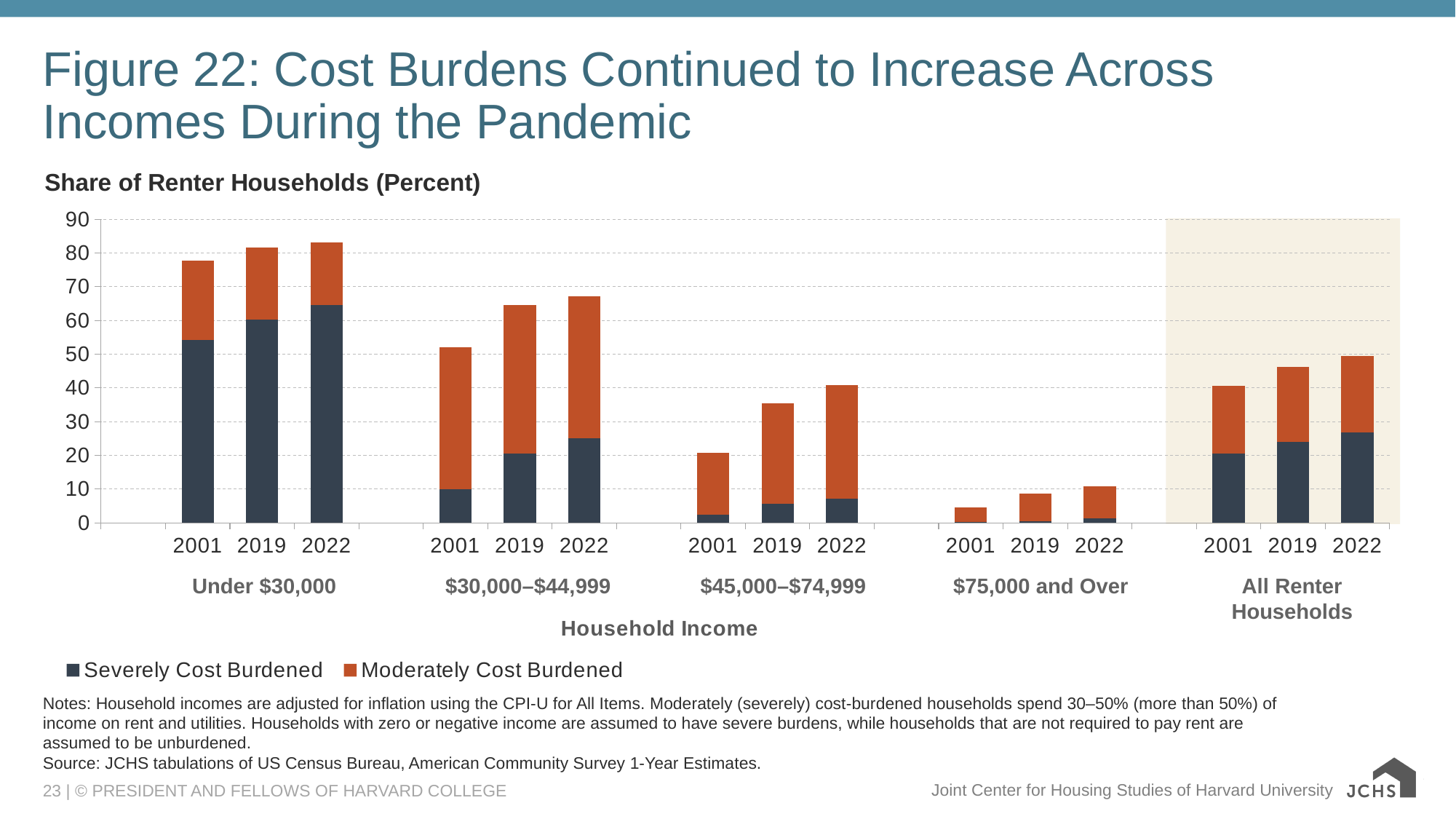
How many series does the legend list? 2 What are the two series named in the legend? Severely Cost Burdened and Moderately Cost Burdened What kind of chart is shown on the slide? Stacked bar chart Which income group and year has the highest total share of cost-burdened renter households? Under $30,000 in 2022 Is the Severely Cost Burdened share for the Under $30,000 group in 2022 greater or less than 60? greater Is the total cost-burdened share for the $45,000–$74,999 group in 2019 greater or less than 30? greater Is the total cost-burdened share for All Renter Households in 2022 greater or less than 40? greater Within each income group, do the total cost-burdened shares rise or fall from 2001 to 2022? rise How many bars are plotted in the chart? 15 In 2022, which group has a larger total cost-burdened share: $30,000–$44,999 or $45,000–$74,999? $30,000–$44,999 Which income group and year has the lowest total share of cost-burdened renter households? $75,000 and Over in 2001